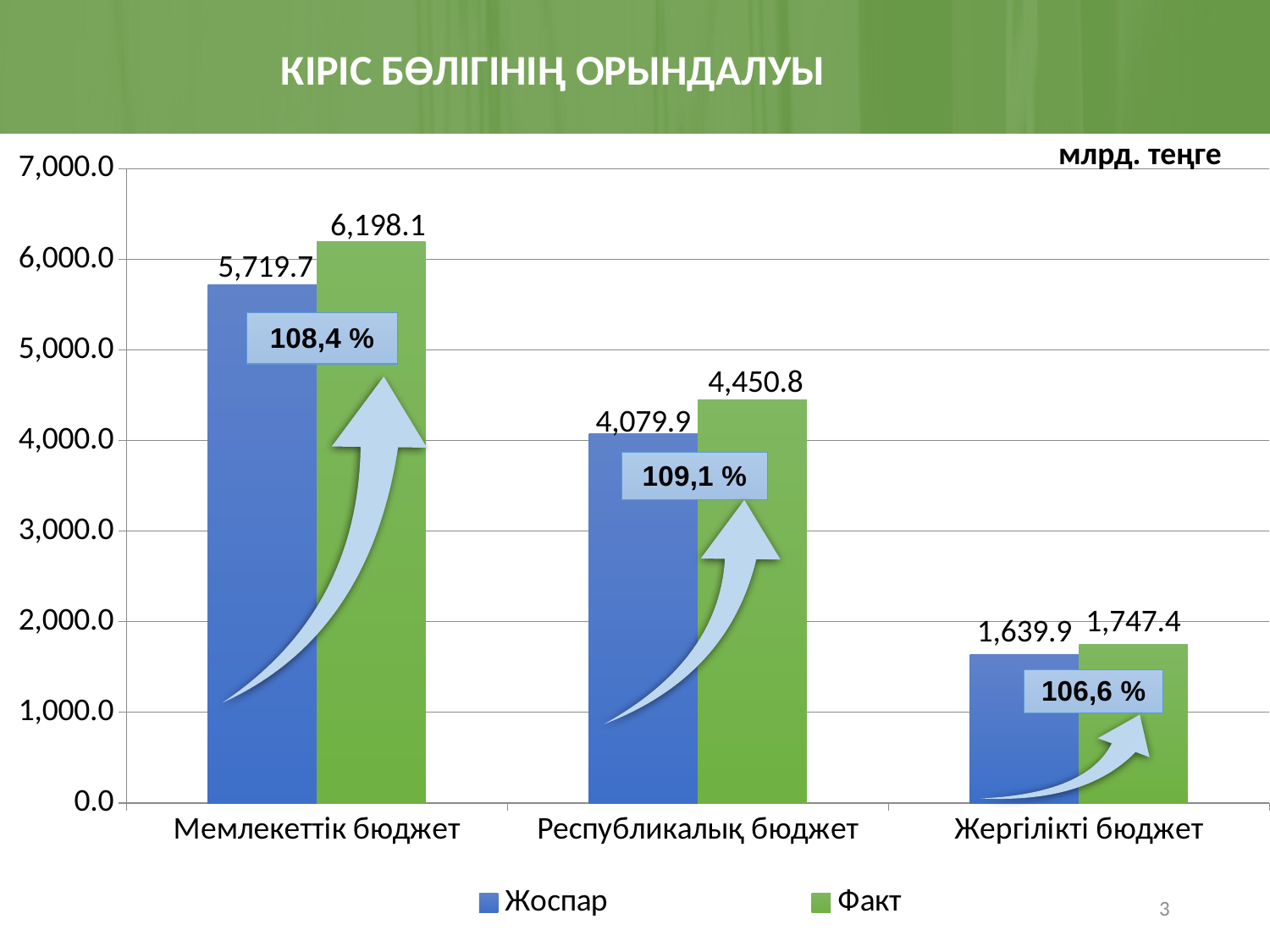
How many series does the legend list? 2 Which category has the highest Факт value? Мемлекеттік бюджет Which category has the lowest Жоспар value? Жергілікті бюджет What is the Жоспар value for Мемлекеттік бюджет? 5,719.7 What is the difference between the Факт and Жоспар values for Жергілікті бюджет? 107.5 What is the Факт value for Республикалық бюджет? 4,450.8 What kind of chart is shown on the slide? Bar chart What percentage label is shown above the Республикалық бюджет bars? 109,1 % Which is larger for Республикалық бюджет, the Жоспар value or the Факт value? Факт What is the Факт value for Жергілікті бюджет? 1,747.4 How many categories are shown on the x axis? 3 What is the difference between the Факт and Жоспар values for Мемлекеттік бюджет? 478.4